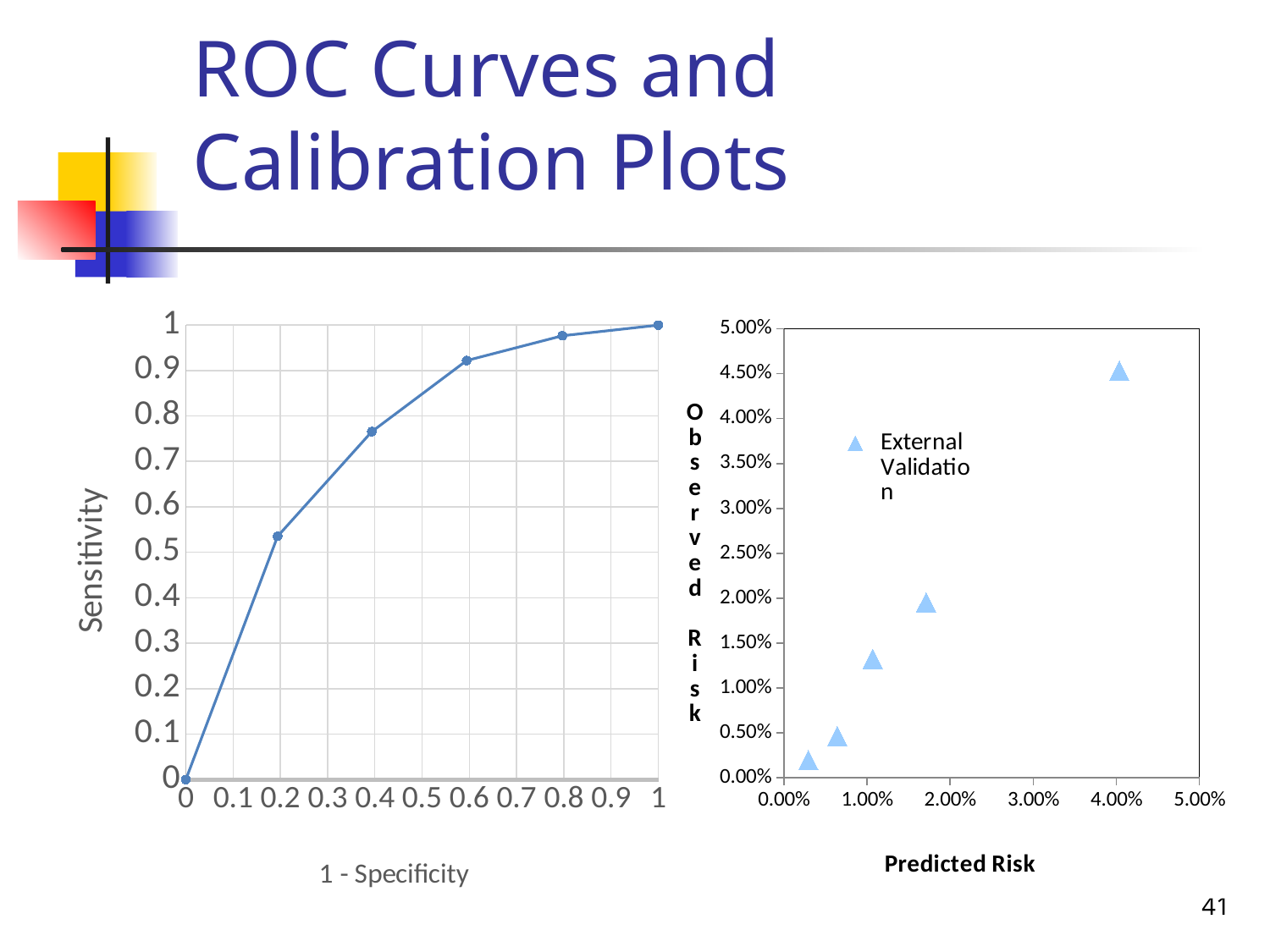
What type of chart is the left chart on the slide? line chart In the left chart, is the sensitivity at 1 - Specificity = 0.4 greater or less than 0.7? greater In the left chart, how many data points are plotted on the line? 6 In the left chart, what is the sensitivity when 1 - Specificity is 1? 1 In the left chart, what is the sensitivity when 1 - Specificity is 0? 0 In the right chart, how many series does the legend list? 1 In the right chart, do the observed risk values rise or fall as predicted risk increases? rise What type of chart is the right chart on the slide? scatter chart In the right chart, is the observed risk for the point with the highest predicted risk greater or less than 4.00%? greater In the right chart, how many data points are plotted? 5 In the right chart, what is the name of the series shown in the legend? External Validation In the left chart, is the sensitivity at 1 - Specificity = 0.2 greater or less than 0.4? greater